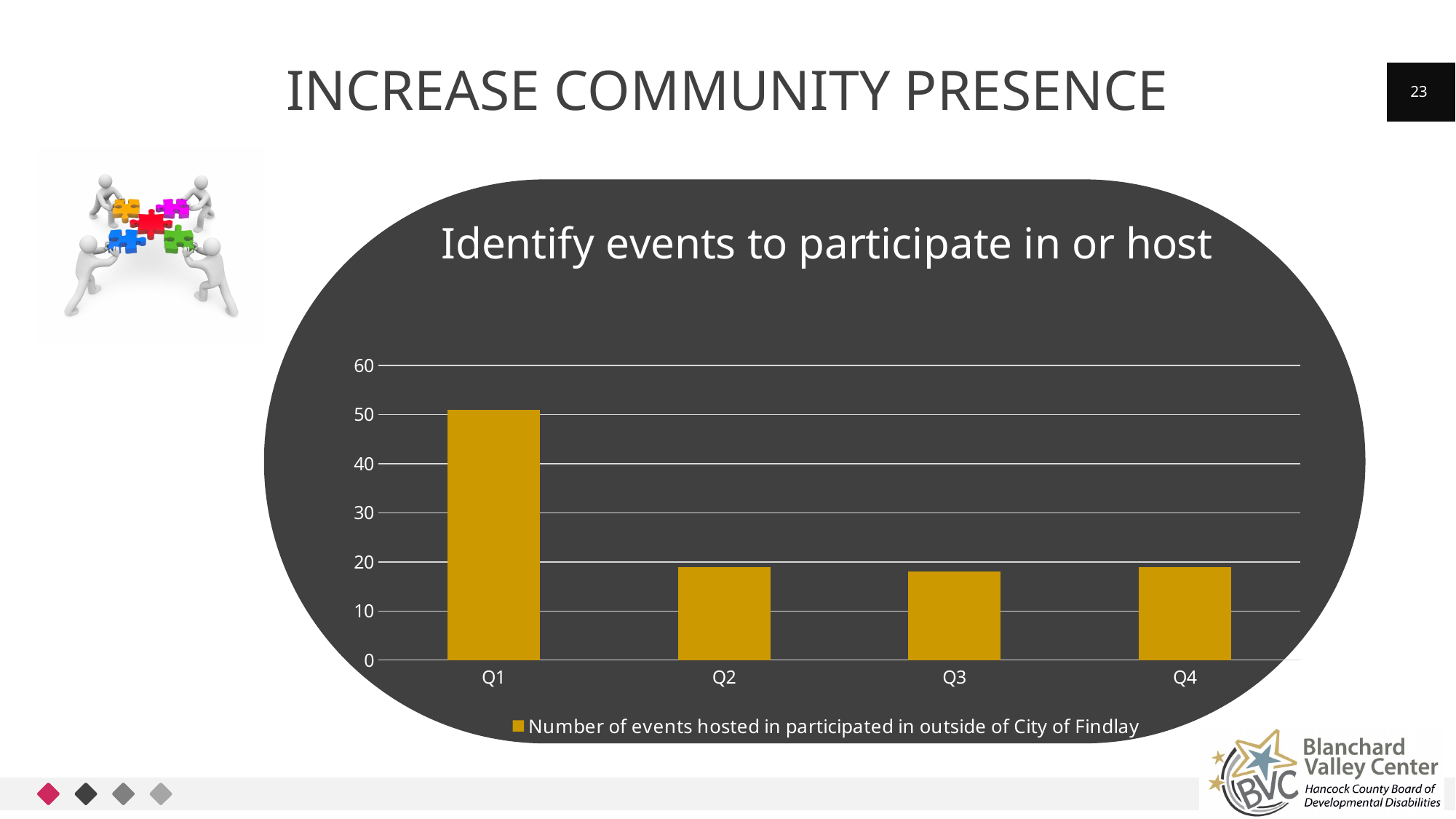
Is the value for Q4 greater or less than 30? less What is the title of the chart? Identify events to participate in or host Is the value for Q3 greater or less than 10? greater How many categories are shown on the x axis of the chart? 4 Which is larger, the value for Q3 or the value for Q1? Q1 What series name does the legend show? Number of events hosted in participated in outside of City of Findlay How many series does the chart's legend list? 1 Which is larger, the value for Q1 or the value for Q2? Q1 What kind of chart is shown on the slide? bar chart Which quarter has the highest number of events? Q1